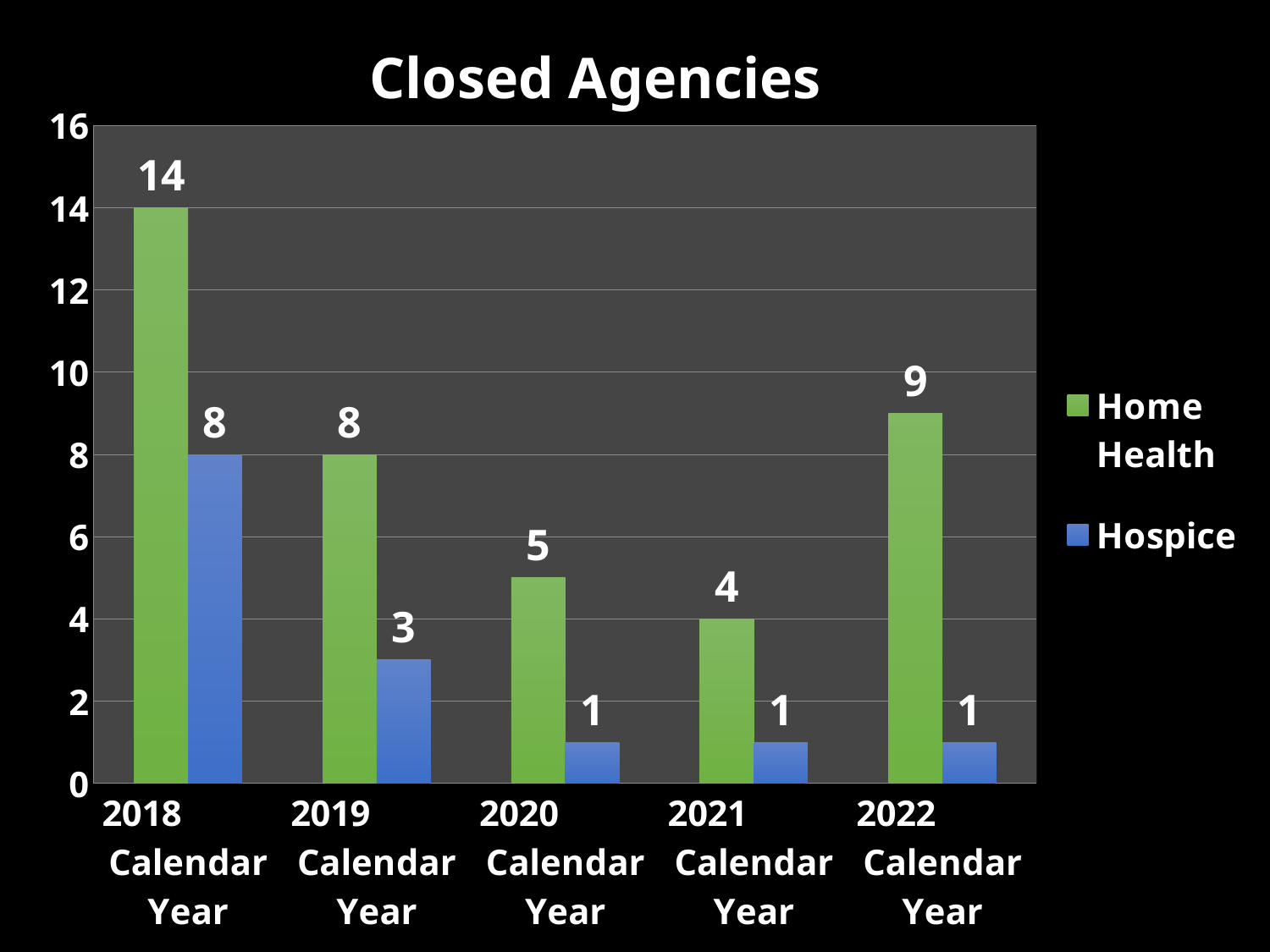
What is the difference between the Home Health values for the 2019 and 2020 Calendar Years? 3 Which is larger, the Hospice value for 2018 or the Hospice value for 2019? 2018 How many calendar years are shown on the x axis? 5 What is the Home Health value for the 2022 Calendar Year? 9 What kind of chart is shown on the slide? Bar chart Which calendar year has the highest Home Health value? 2018 Calendar Year What is the difference between the Home Health and Hospice values in the 2018 Calendar Year? 6 Which calendar year has the lowest Home Health value? 2021 Calendar Year What is the Home Health value for the 2018 Calendar Year? 14 How many series does the legend list? 2 What is the title of the chart? Closed Agencies What is the Hospice value for the 2019 Calendar Year? 3